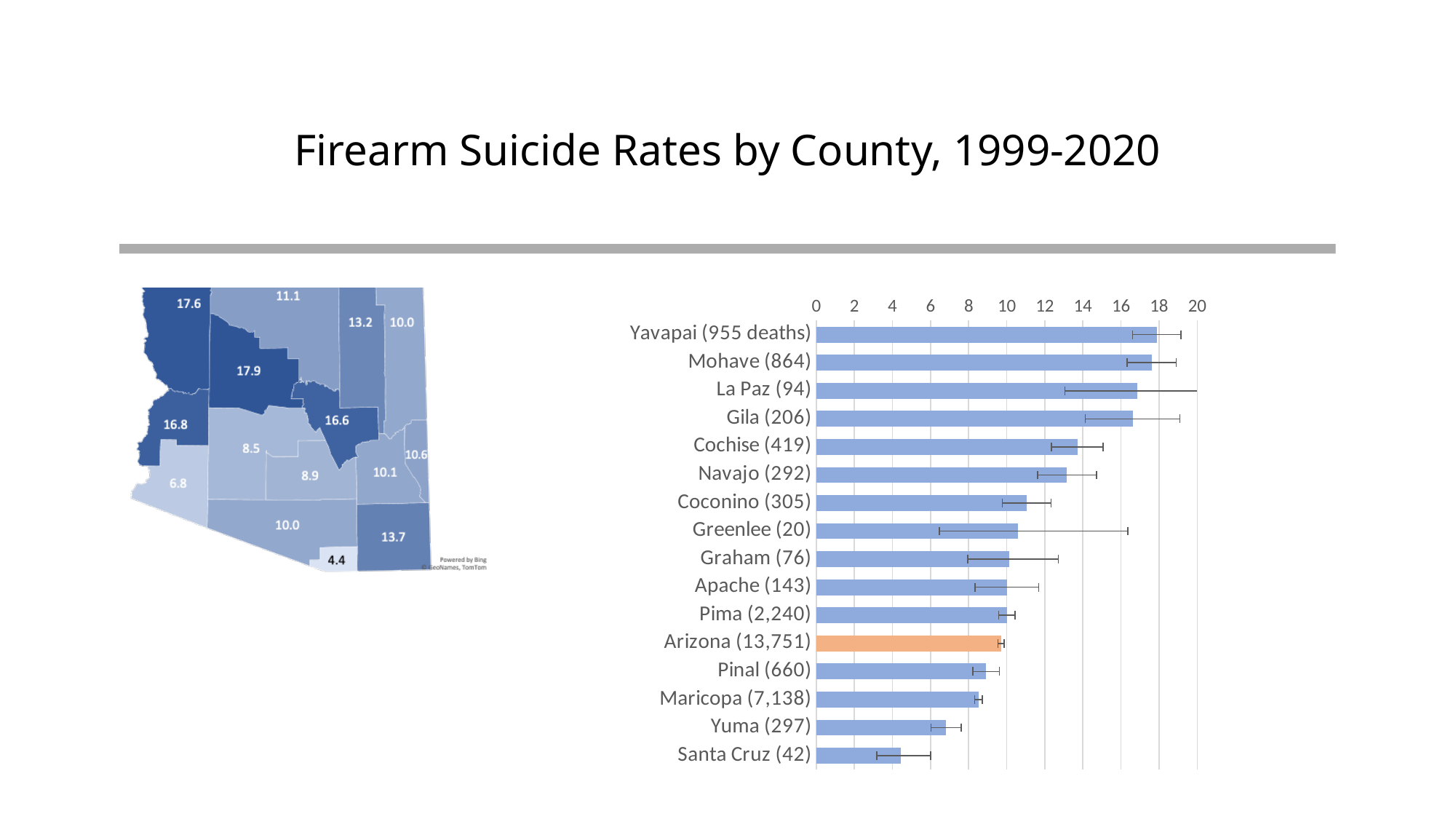
In the bar chart, is the value for Yavapai (955 deaths) greater or less than 16? greater How many bars are plotted in the bar chart? 16 Which bar in the bar chart is coloured orange instead of blue? Arizona (13,751) In the bar chart, which is larger, the value for La Paz (94) or the value for Cochise (419)? La Paz (94) In the bar chart, which is larger, the value for Coconino (305) or the value for Maricopa (7,138)? Coconino (305) In the bar chart, which category has the lowest value? Santa Cruz (42) In the bar chart, is the value for Maricopa (7,138) greater or less than 10? less What type of chart is shown on the right side of the slide? bar chart In the bar chart, is the value for Navajo (292) greater or less than 12? greater What number of deaths is shown in the bar chart label for Pima? 2,240